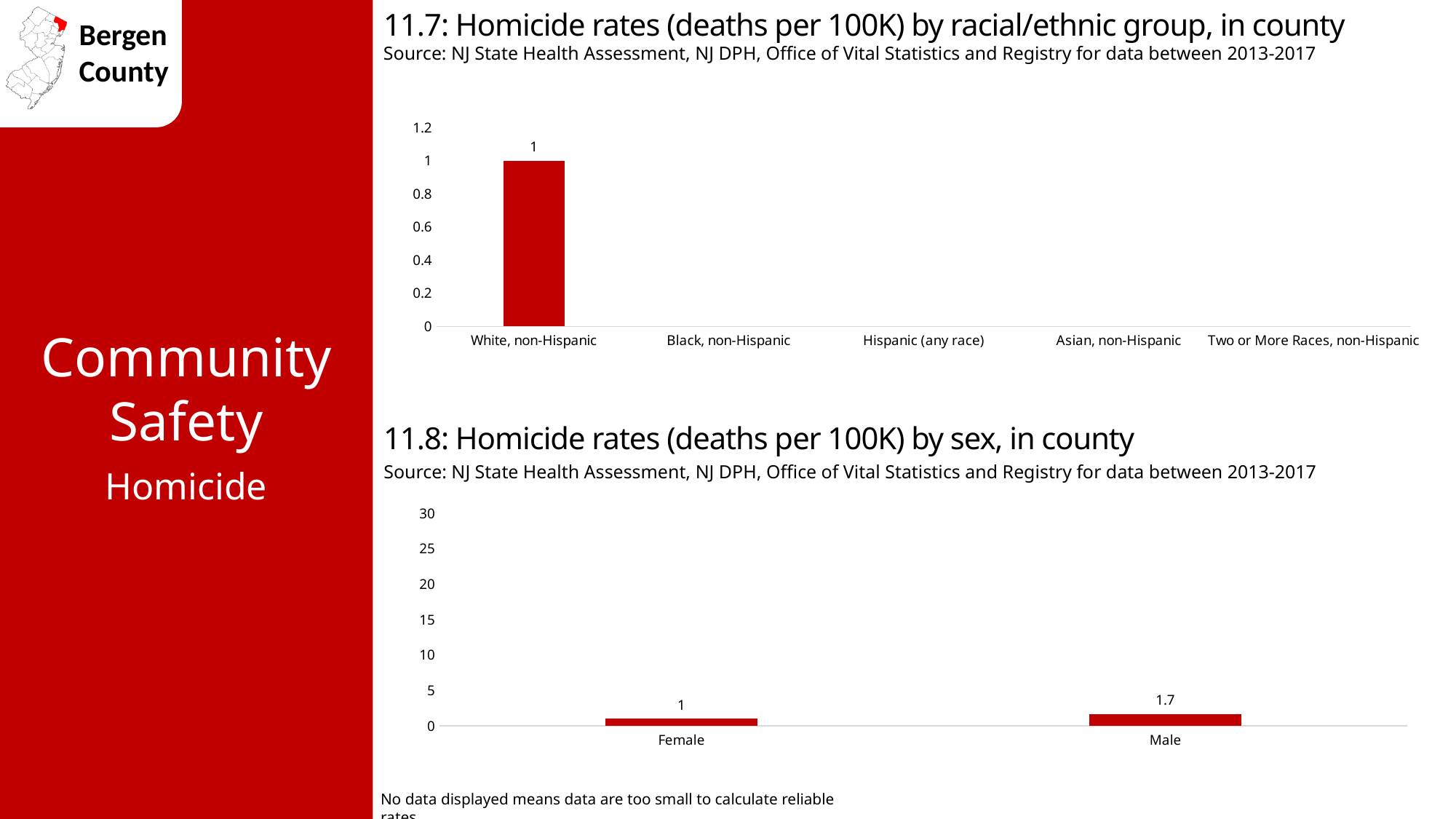
In the chart '11.7: Homicide rates (deaths per 100K) by racial/ethnic group, in county', which category is the only one with a bar displayed? White, non-Hispanic In the chart '11.8: Homicide rates (deaths per 100K) by sex, in county', which sex has the lower homicide rate? Female In the chart '11.7: Homicide rates (deaths per 100K) by racial/ethnic group, in county', how many racial/ethnic group categories are listed on the x axis? 5 In the chart '11.8: Homicide rates (deaths per 100K) by sex, in county', how many categories are shown on the x axis? 2 What kind of chart is '11.7: Homicide rates (deaths per 100K) by racial/ethnic group, in county'? Bar chart In the chart '11.8: Homicide rates (deaths per 100K) by sex, in county', what is the homicide rate for Female? 1 In the chart '11.8: Homicide rates (deaths per 100K) by sex, in county', is the value for Male greater or less than 5? less In the chart '11.8: Homicide rates (deaths per 100K) by sex, in county', which sex has the higher homicide rate? Male In the chart '11.8: Homicide rates (deaths per 100K) by sex, in county', what is the difference between the Male and Female homicide rates? 0.7 In the chart '11.8: Homicide rates (deaths per 100K) by sex, in county', what is the homicide rate for Male? 1.7 In the chart '11.7: Homicide rates (deaths per 100K) by racial/ethnic group, in county', what is the homicide rate for White, non-Hispanic? 1 In the chart '11.7: Homicide rates (deaths per 100K) by racial/ethnic group, in county', is the value for White, non-Hispanic greater or less than 0.8? greater